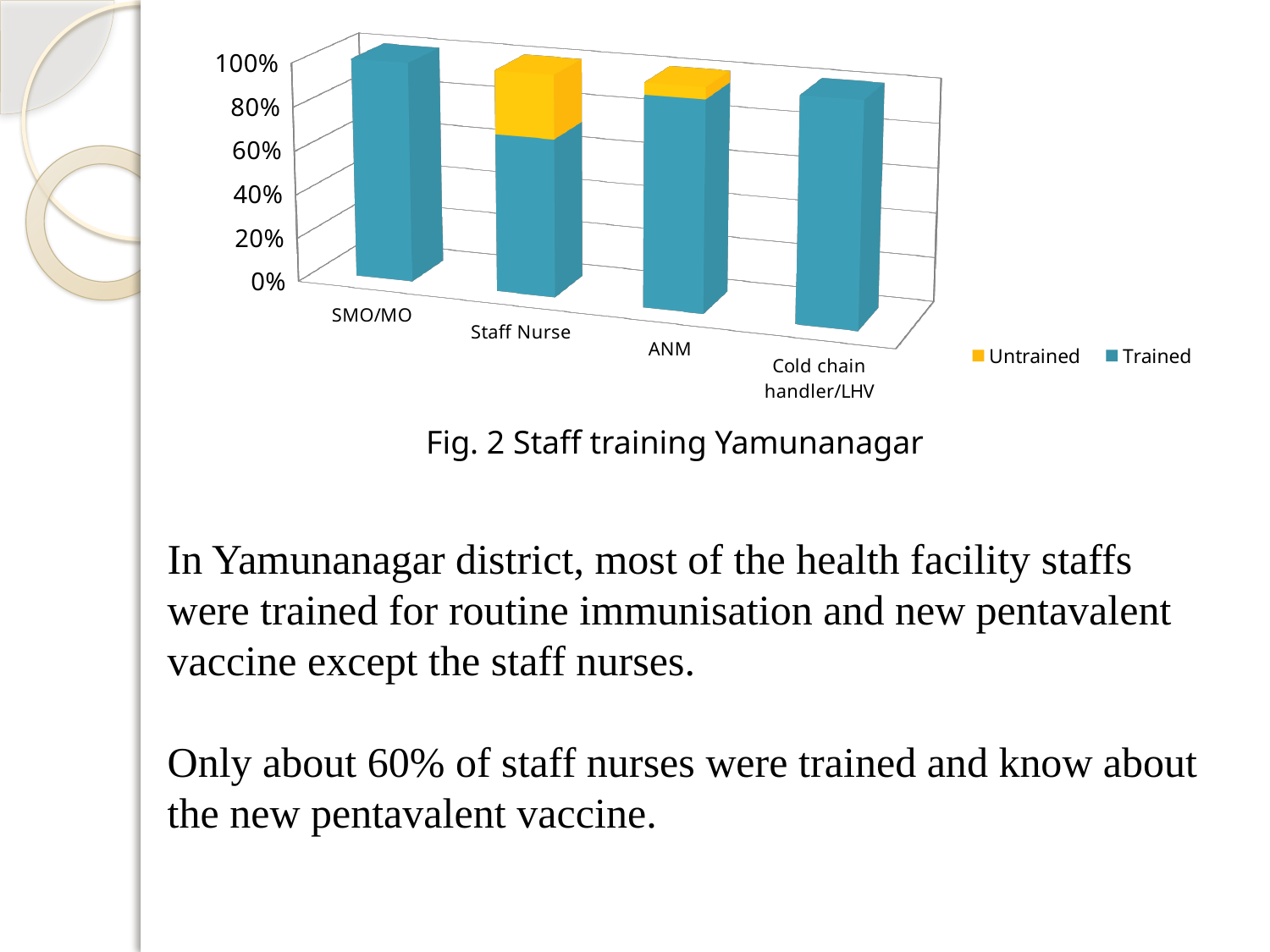
Which colour represents the Untrained series in the chart legend? yellow Is the Trained value for SMO/MO greater or less than 80%? greater Which staff category has the lowest Trained value? Staff Nurse Is the Trained value for ANM greater or less than 60%? greater What is the caption/title of the chart? Fig. 2 Staff training Yamunanagar How many staff categories are shown on the x axis of the chart? 4 Which staff category has the highest Untrained value? Staff Nurse What kind of chart is shown on the slide? bar chart Is the Trained value for Staff Nurse greater or less than 80%? less Which has the larger Trained value, Staff Nurse or ANM? ANM How many series does the chart legend list? 2